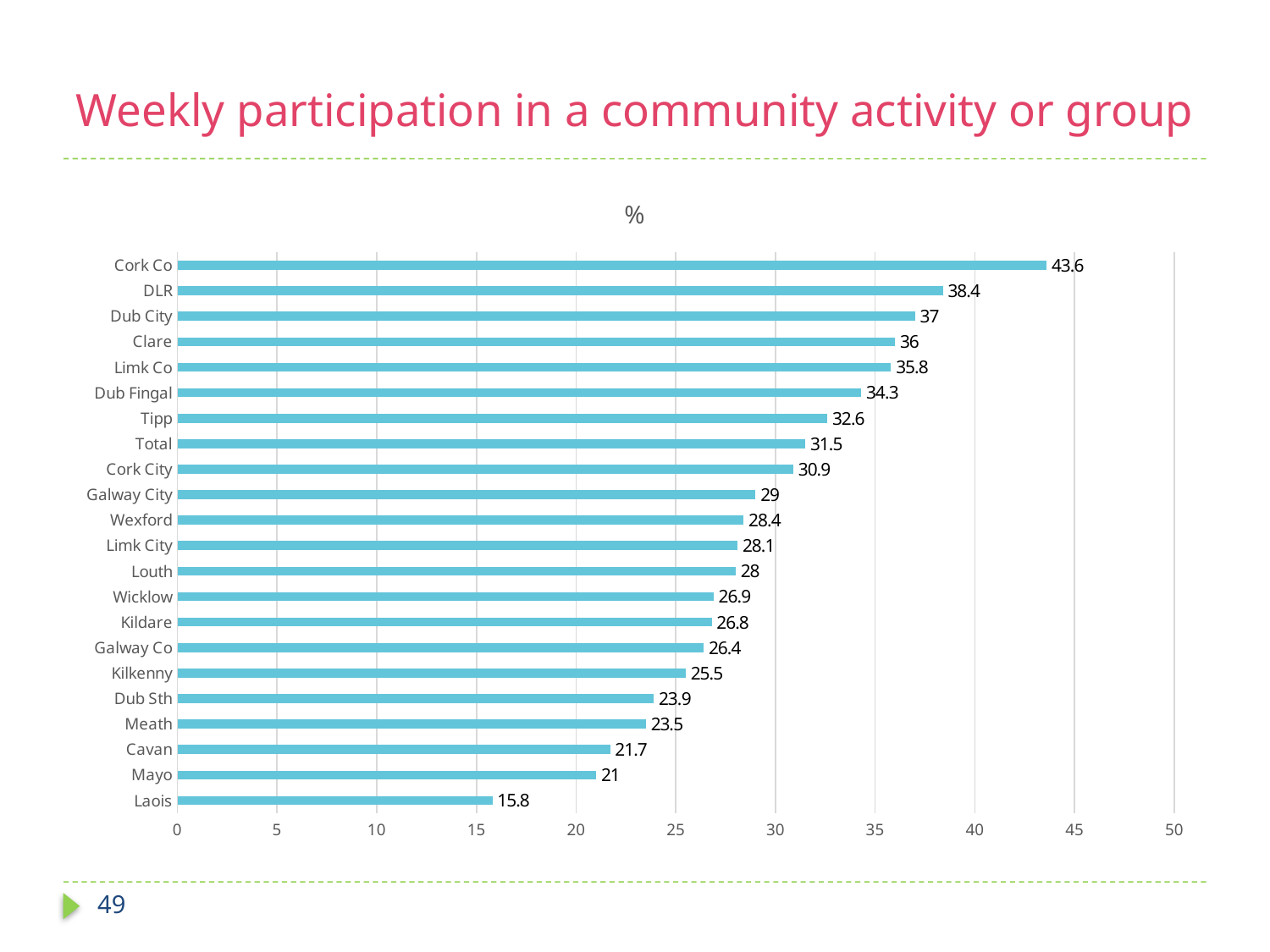
What is the value for Total? 31.5 What is the value for Cork Co? 43.6 What is the value for Galway City? 29 Which category has the highest value? Cork Co What is the value for Laois? 15.8 What is the difference between the values for DLR and Dub City? 1.4 What kind of chart is shown on the slide? Bar chart How many categories are shown on the chart? 22 Which is larger, the value for Tipp or the value for Cork City? Tipp What is the title of the chart? % Which category has the lowest value? Laois Is the value for Clare greater or less than 35? greater